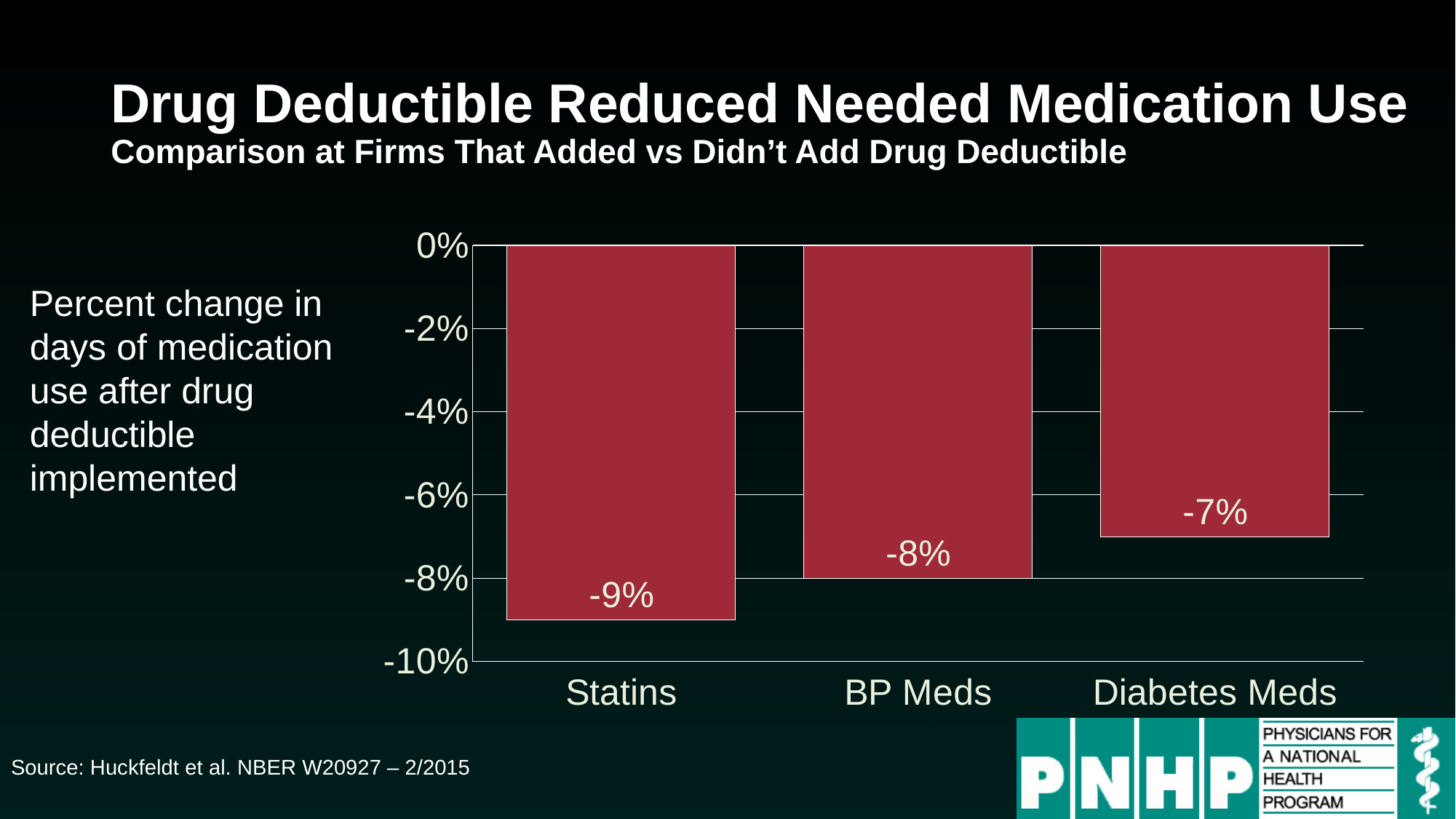
What is the title of the slide containing the chart? Drug Deductible Reduced Needed Medication Use Which category had a larger decline in medication use, BP Meds or Diabetes Meds? BP Meds What is the percent change in days of medication use for BP Meds? -8% How many medication categories are shown on the chart? 3 What is the lowest value shown on the vertical axis? -10% What kind of chart is shown on the slide? Bar chart What is the percent change in days of medication use for Statins? -9% What is the percent change in days of medication use for Diabetes Meds? -7% Which medication category shows the largest decline in days of medication use? Statins What is the difference in percentage points between the change for Statins and the change for Diabetes Meds? 2 percentage points Do the declines get larger or smaller moving from Statins to Diabetes Meds along the x axis? Smaller Which medication category shows the smallest decline in days of medication use? Diabetes Meds